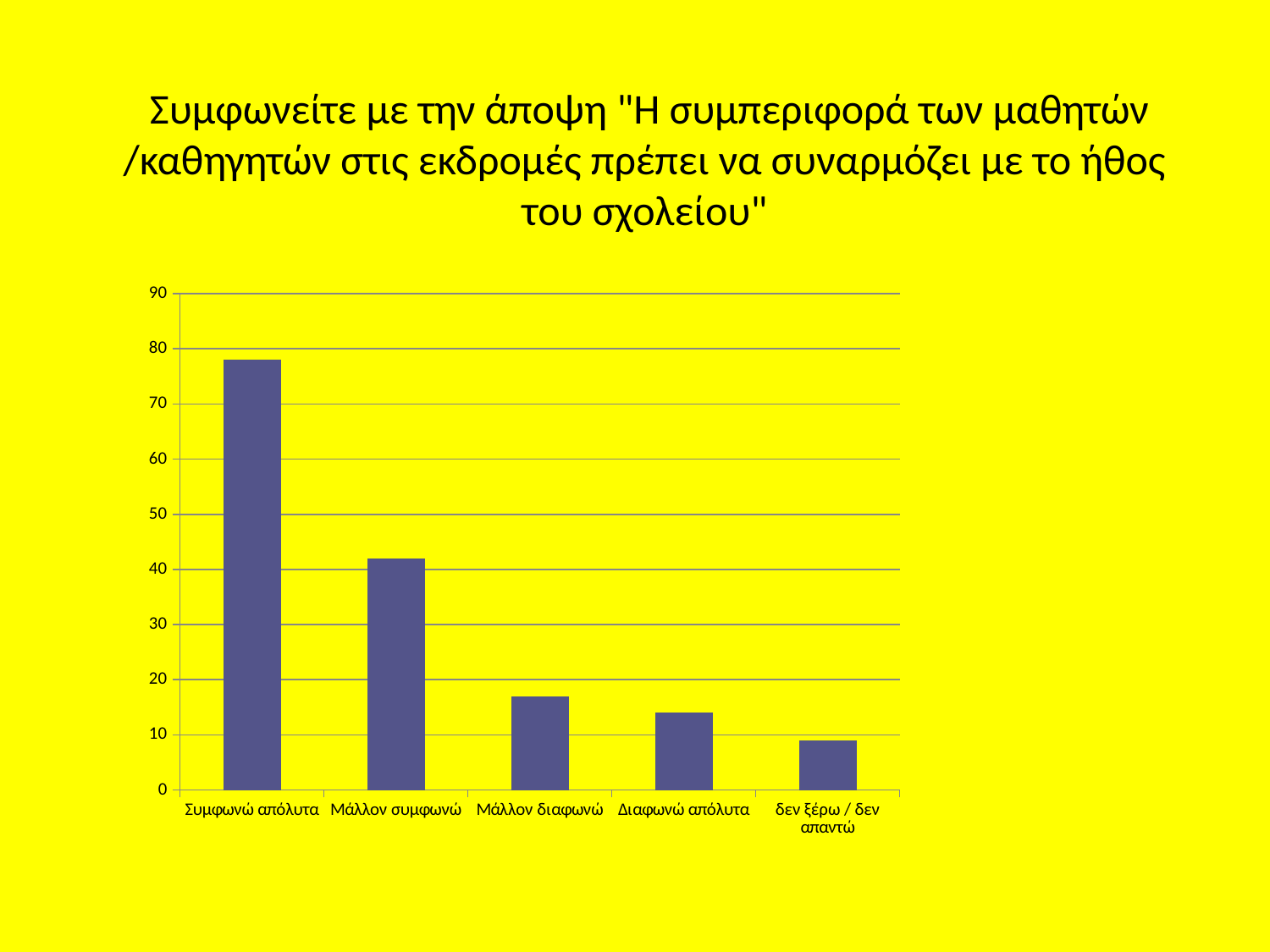
How many categories are shown on the x axis of the chart? 5 Which category has the lowest value in the chart? δεν ξέρω / δεν απαντώ Is the value for Συμφωνώ απόλυτα greater or less than 70? greater Is the value for Διαφωνώ απόλυτα greater or less than 10? greater Which is larger, the value for Μάλλον συμφωνώ or the value for Μάλλον διαφωνώ? Μάλλον συμφωνώ What is the highest value shown on the vertical axis of the chart? 90 Is the value for Μάλλον διαφωνώ greater or less than 20? less Which category has the highest value in the chart? Συμφωνώ απόλυτα What kind of chart is shown on the slide? bar chart Do the bar values rise or fall from left to right along the x axis? fall